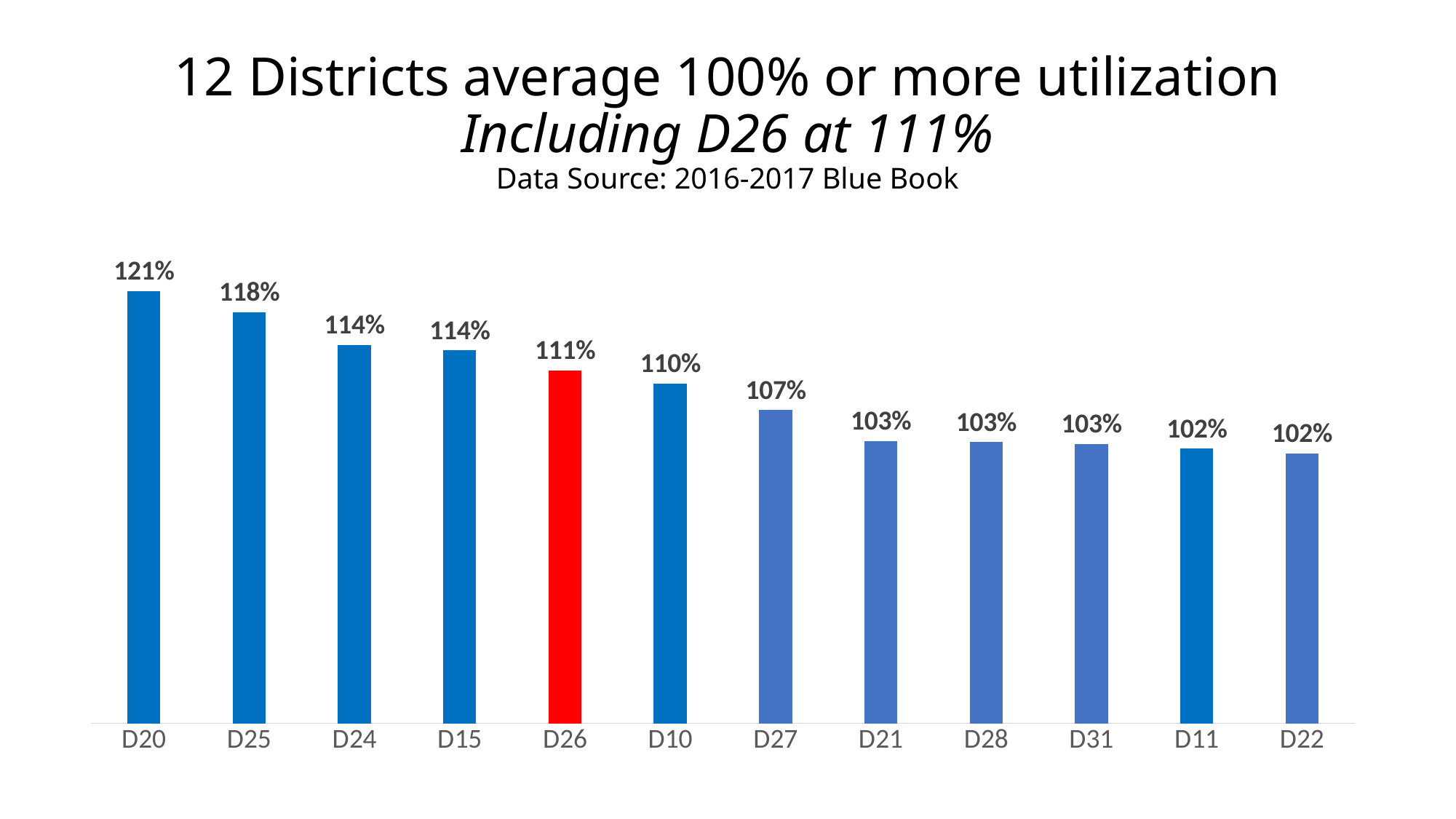
Which district has the highest utilization? D20 Do the values rise or fall from left to right along the x axis? Fall What is the difference between the utilization of D20 and D25? 3% What is the difference between the utilization of D26 and D22? 9% What is the utilization value for D26? 111% What is the utilization value for D27? 107% Which has a higher utilization, D27 or D25? D25 What is the utilization value for D10? 110% Which has a higher utilization, D15 or D10? D15 What kind of chart is shown on the slide? Bar chart How many districts are shown in the chart? 12 Which district's bar is coloured red? D26